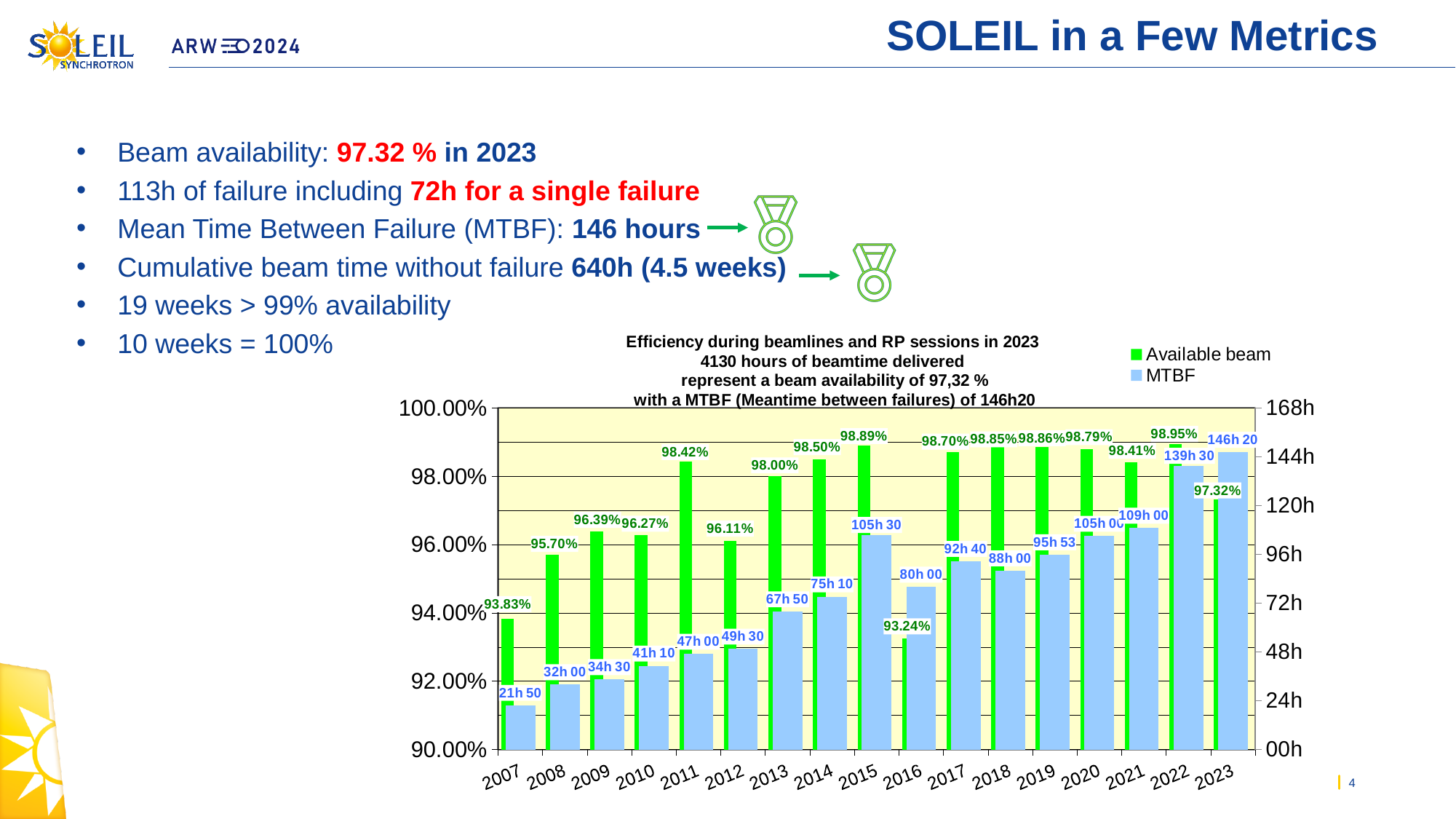
What is the Available beam value for 2016? 93.24% How many years are shown on the x axis of the chart? 17 What is the MTBF value for 2022? 139h 30 Which year has the lowest Available beam value? 2016 What is the Available beam value for 2023? 97.32% How many series does the chart legend list? 2 What kind of chart is shown on the slide? Bar chart Which year has the lowest MTBF value? 2007 What is the MTBF value for 2007? 21h 50 Is the Available beam value for 2011 larger than the value for 2012? Yes Which year has the highest MTBF value? 2023 Which year has the highest Available beam value? 2022